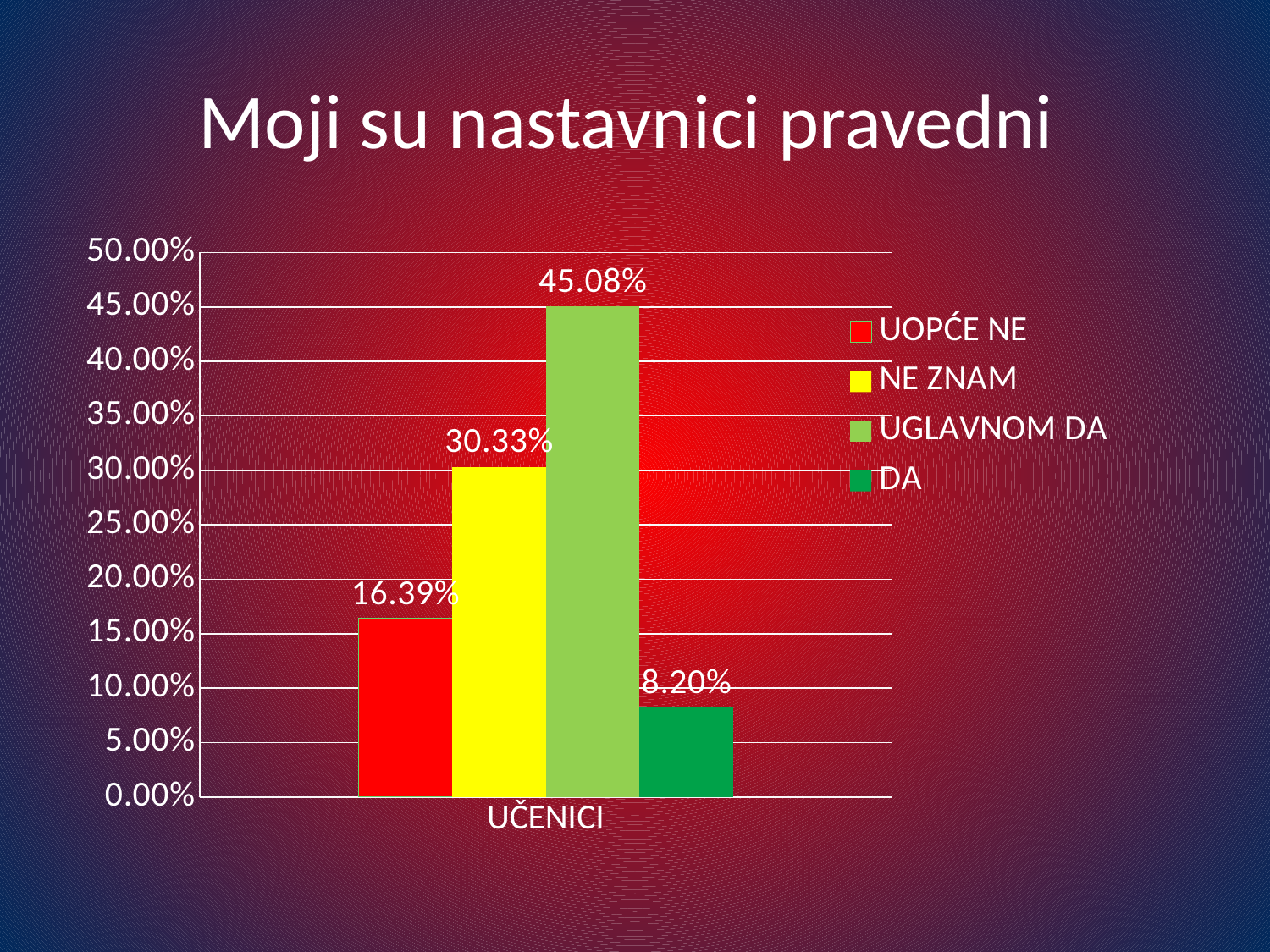
What is the value for NE ZNAM? 30.33% What is the value for DA? 8.20% What kind of chart is shown on the slide? bar chart What is the difference between the values for UGLAVNOM DA and NE ZNAM? 14.75% What is the value for UGLAVNOM DA? 45.08% What is the value for UOPĆE NE? 16.39% Which is larger, the value for UOPĆE NE or the value for DA? UOPĆE NE Which series has the highest value? UGLAVNOM DA Which series has the lowest value? DA Is the value for NE ZNAM greater or less than 25.00%? greater How many series does the legend list? 4 What is the title of the chart? Moji su nastavnici pravedni